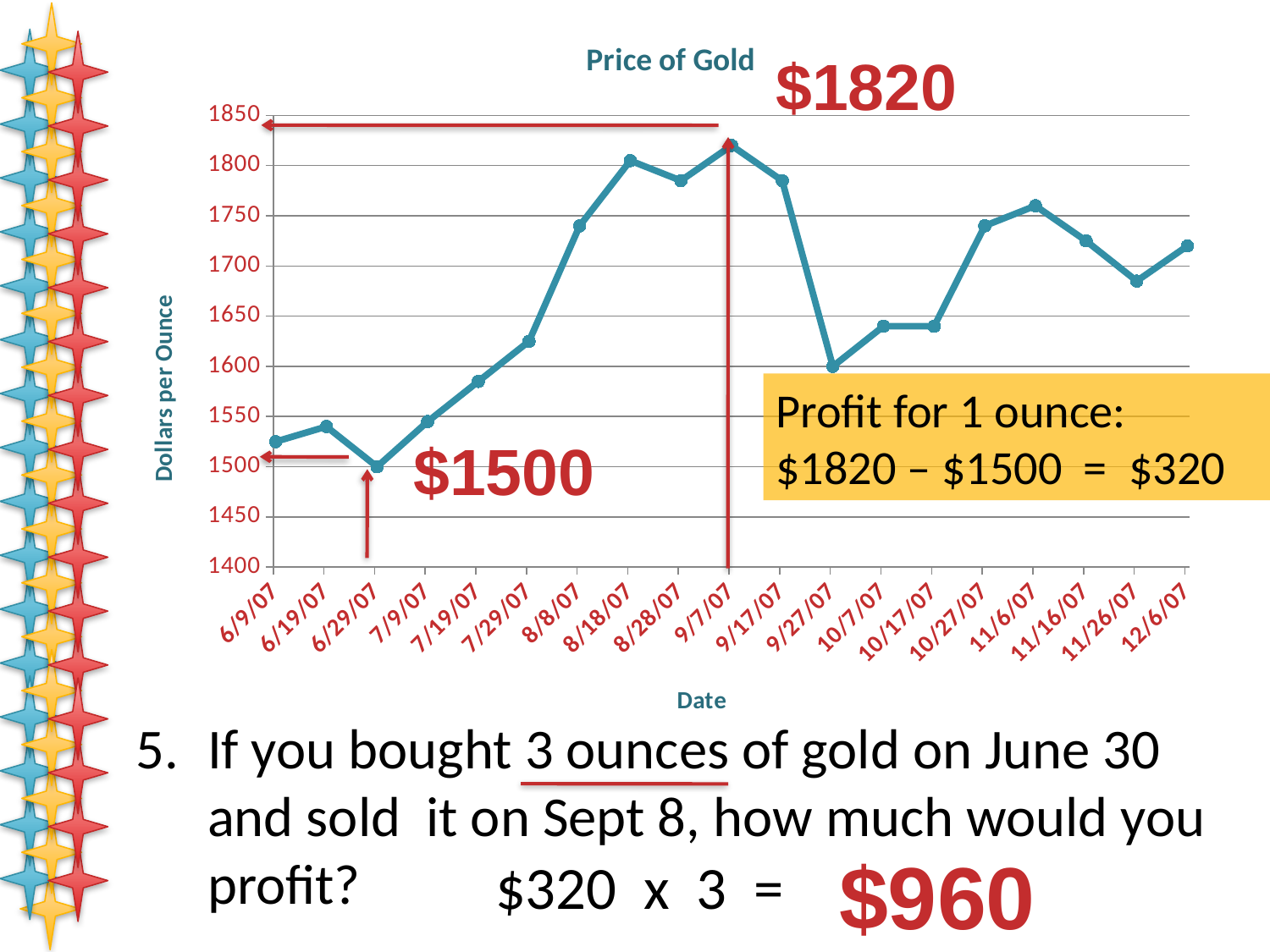
What is the title of the chart? Price of Gold Is the price of gold on 9/27/07 greater or less than 1650? less How many data points are plotted on the chart? 19 What is the label on the vertical axis of the chart? Dollars per Ounce On which date does the price of gold reach its lowest value? 6/29/07 On which date does the price of gold reach its highest value? 9/7/07 What is the price of gold on 6/29/07 according to the chart annotation? $1500 What is the difference between the price on 9/7/07 and the price on 6/29/07? $320 What kind of chart is shown on the slide? line chart What is the price of gold on 9/7/07 according to the chart annotation? $1820 Is the price of gold on 8/18/07 greater or less than 1750? greater Does the price of gold rise or fall between 6/29/07 and 9/7/07? rise